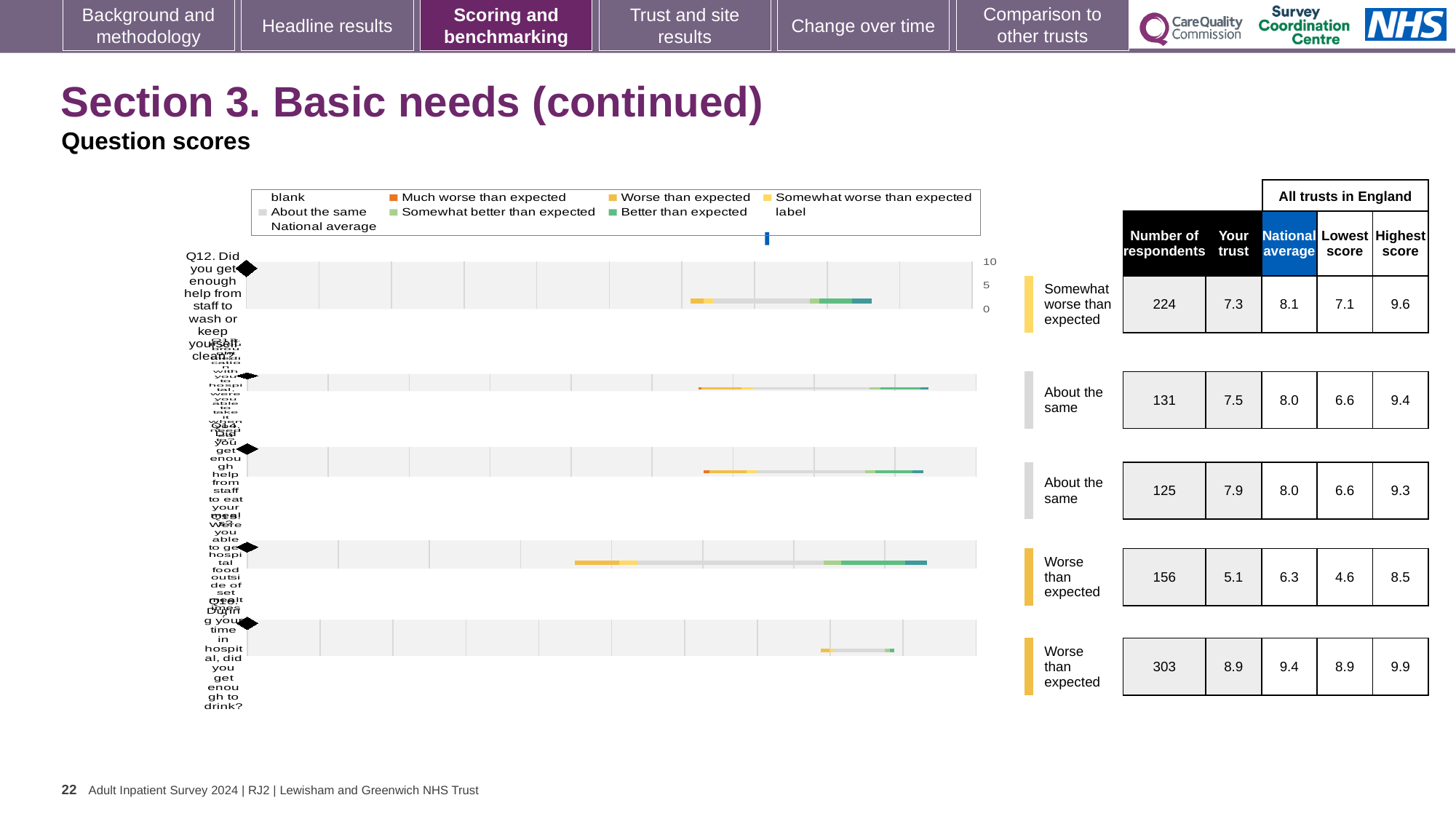
In the chart legend, what colour represents 'About the same'? grey For the first row (Q12), is the 'Your trust' score higher or lower than the national average? lower How many question bars are plotted in the chart? 5 In the table beside the chart, how many respondents are listed for the first row (Q12)? 224 What is the title of the slide containing the chart? Section 3. Basic needs (continued) In the table beside the chart, what is the 'Your trust' score for the first row (Q12)? 7.3 What is the lowest 'Your trust' score shown in the table beside the chart? 5.1 For the first row (Q12), what is the difference between the national average and the 'Your trust' score? 0.8 What benchmark category is shown for the first row (Q12)? Somewhat worse than expected What is the highest 'Your trust' score shown in the table beside the chart? 8.9 In the table beside the chart, what is the national average for the first row (Q12)? 8.1 What kind of chart is used to show the question scores on this slide? bar chart